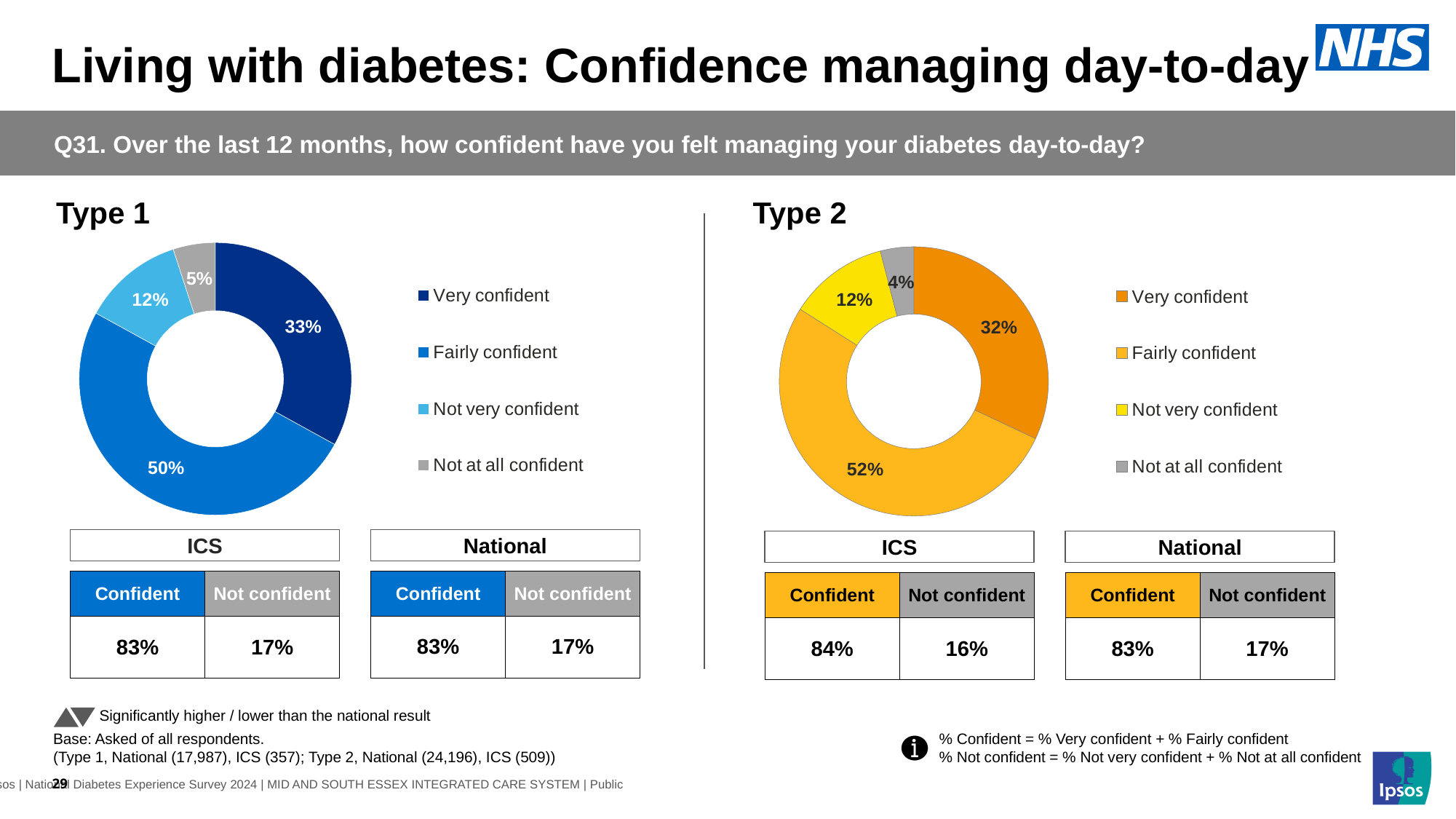
In the Type 2 chart, what percentage of respondents were Fairly confident? 52% In the Type 1 chart, what is the difference between the Fairly confident and Very confident shares? 17 percentage points In the Type 2 chart, what colour is the Not very confident segment? Yellow What kind of chart is used for Type 2? Doughnut chart How many entries does the legend of the Type 1 chart list? 4 In the Type 1 chart, which category has the largest share? Fairly confident In the Type 1 chart, what is the combined share of Not very confident and Not at all confident? 17% In the Type 2 chart, what is the combined share of Very confident and Fairly confident? 84% How many categories does the Type 1 chart show? 4 In the Type 2 chart, is the share for Not very confident larger or smaller than the share for Not at all confident? larger In the Type 2 chart, which category has the smallest share? Not at all confident In the Type 1 chart, what percentage of respondents were Very confident? 33%